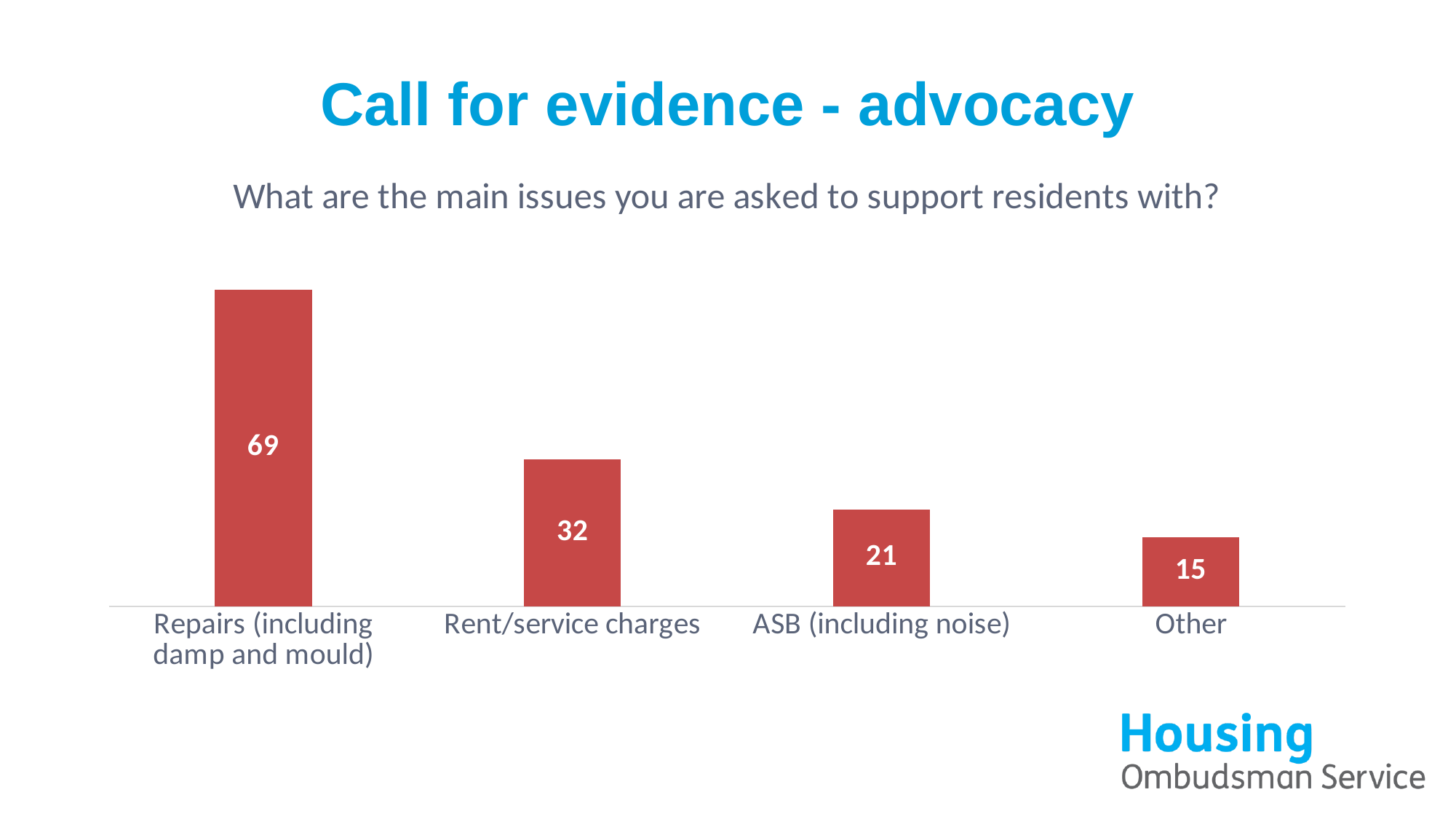
Which category has the highest value? Repairs (including damp and mould) What is the value for Rent/service charges? 32 What is the difference between the values for Repairs (including damp and mould) and Rent/service charges? 37 What kind of chart is shown on the slide? Bar chart What question does the chart title ask? What are the main issues you are asked to support residents with? What is the value for Repairs (including damp and mould)? 69 What is the value for Other? 15 Which is larger, the value for Rent/service charges or the value for ASB (including noise)? Rent/service charges What is the value for ASB (including noise)? 21 Which category has the lowest value? Other What is the difference between the values for ASB (including noise) and Other? 6 How many categories are shown in the chart? 4